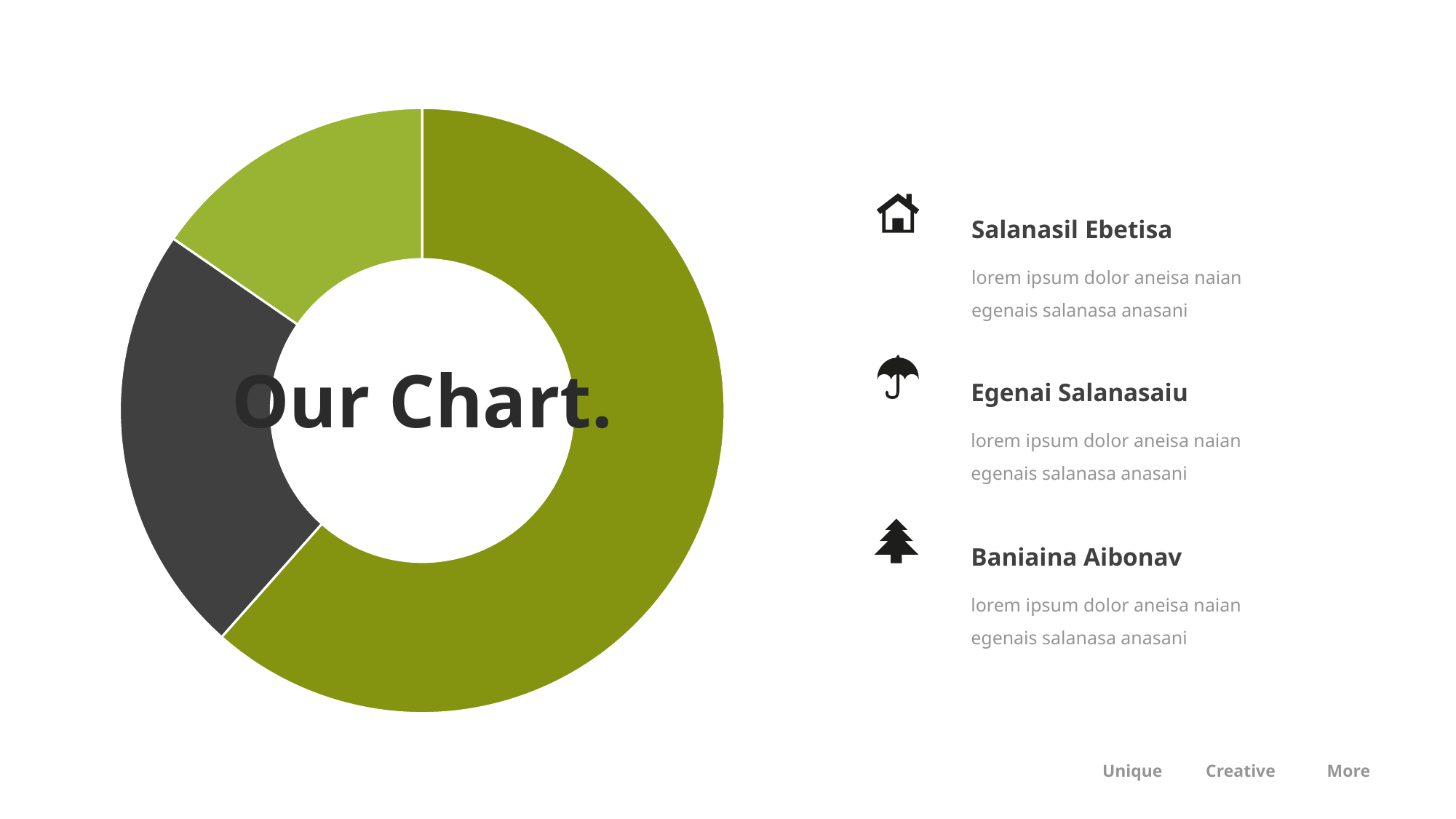
What text is written in the centre of the donut chart? Our Chart. Does the donut chart display any data labels or a legend? No What kind of chart is shown on the slide? Donut chart Which colour slice is the smallest in the donut chart? Light green Which slice is larger, the olive green slice or the dark gray slice? Olive green Which slice is larger, the dark gray slice or the light green slice? Dark gray Which colour slice is the largest in the donut chart? Olive green How many slices does the donut chart have? 3